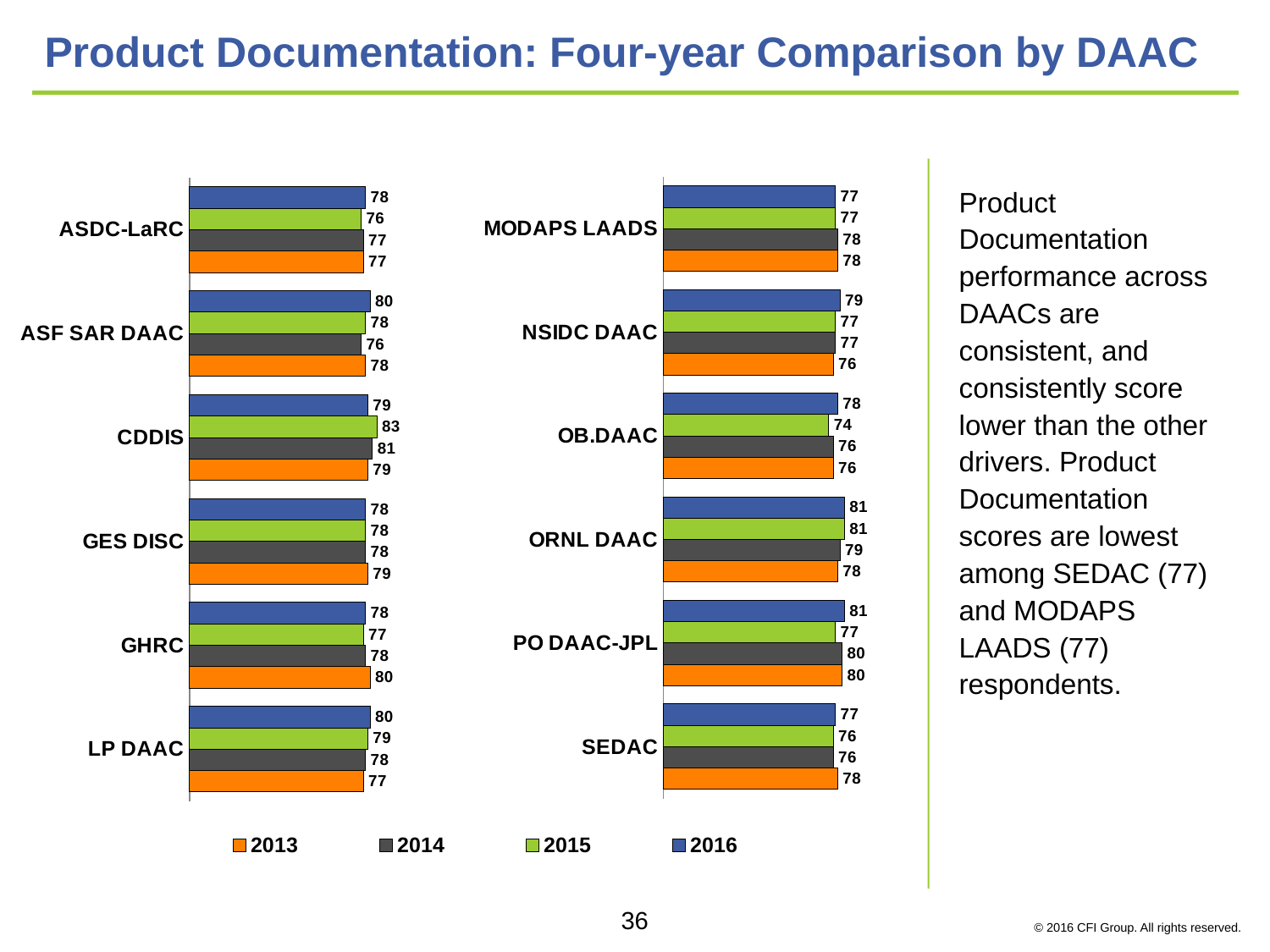
On the right chart, which is larger for PO DAAC-JPL: the 2016 value or the 2015 value? 2016 On the left chart, what is the 2015 value for CDDIS? 83 How many series does the legend list? 4 On the left chart, what is the 2013 value for GHRC? 80 Which colour represents 2013 in the legend? Orange On the right chart, which DAAC has the lowest 2015 value? OB.DAAC On the left chart, what is the difference between the 2016 and 2013 values for LP DAAC? 3 On the right chart, what is the 2015 value for OB.DAAC? 74 On the left chart, which DAAC has the highest 2015 value? CDDIS On the right chart, what is the 2016 value for ORNL DAAC? 81 What kind of chart is used on this slide? Bar chart How many DAACs are shown on the right chart? 6